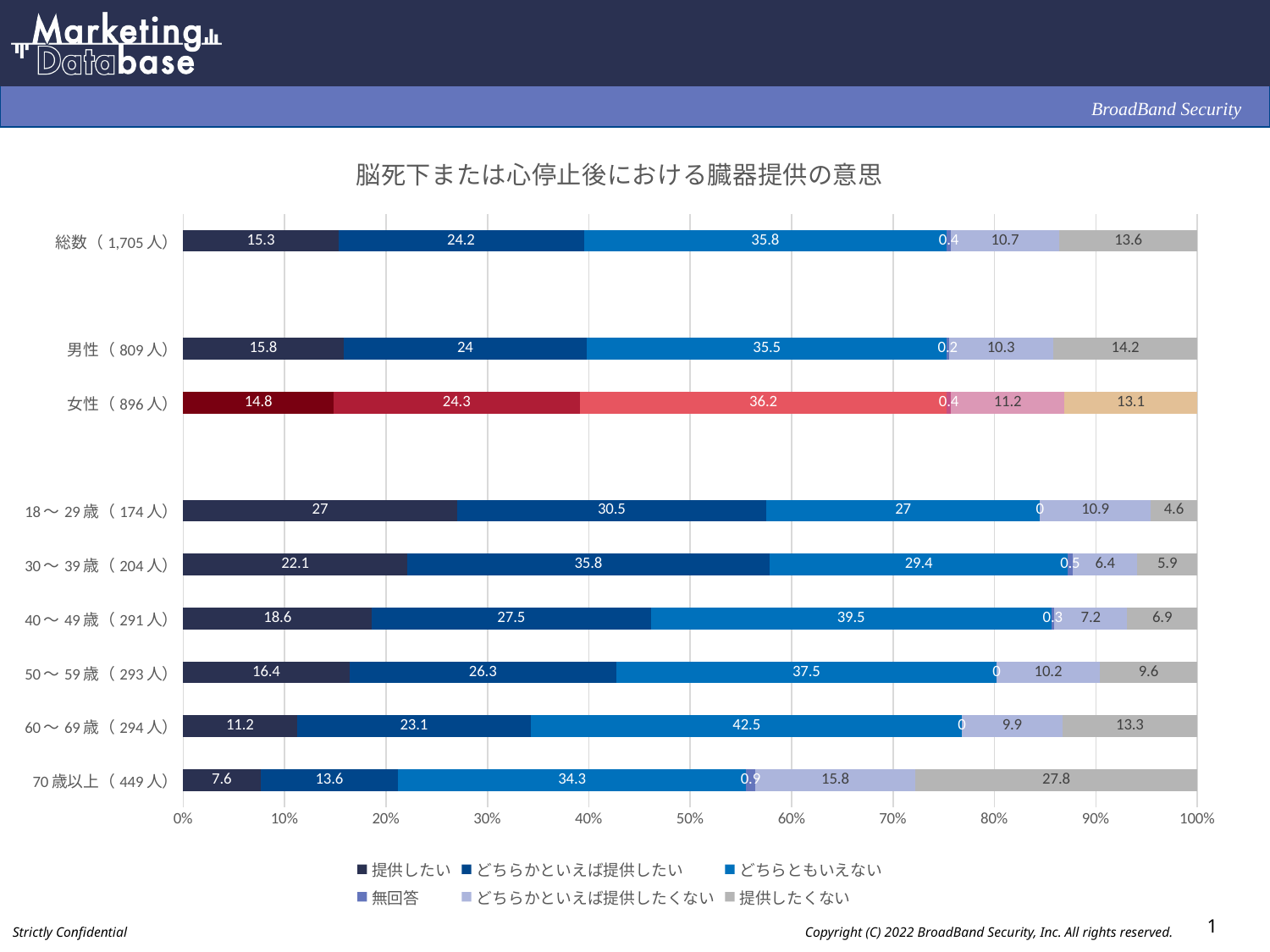
What is the difference between the 提供したくない values for 70歳以上 (449人) and 18〜29歳 (174人)? 23.2 What is the title of the chart? 脳死下または心停止後における臓器提供の意思 Which has the larger どちらともいえない value, 男性 (809人) or 女性 (896人)? 女性 (896人) What is the value of どちらともいえない for 総数 (1,705人)? 35.8 How many categories are shown on the y axis? 9 What is the value of 提供したくない for 70歳以上 (449人)? 27.8 What is the total of the stacked bar for 総数 (1,705人)? 100 What kind of chart is shown on the slide? Stacked bar chart Which category has the lowest value for 提供したい? 70歳以上 (449人) Which category has the highest value for 提供したい? 18〜29歳 (174人) What is the value of どちらかといえば提供したい for 30〜39歳 (204人)? 35.8 How many series does the legend list? 6